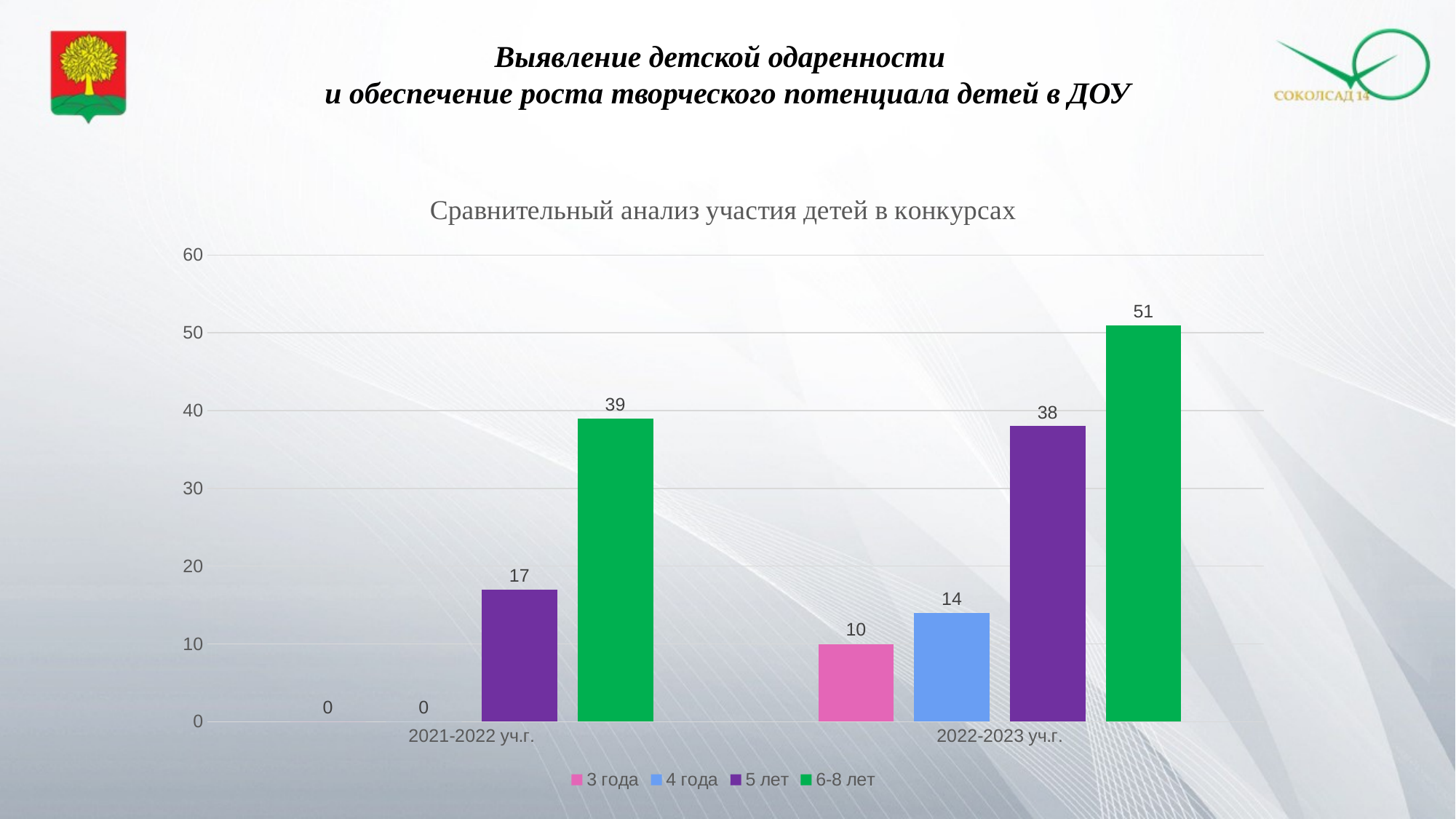
How many series does the legend list? 4 How many categories are shown on the x axis? 2 What kind of chart is shown on the slide? Bar chart Which is larger: the 5 лет value in 2022-2023 уч.г. or the 6-8 лет value in 2021-2022 уч.г.? 6-8 лет value in 2021-2022 уч.г. What is the difference between the 6-8 лет values for 2022-2023 уч.г. and 2021-2022 уч.г.? 12 What is the title of the chart? Сравнительный анализ участия детей в конкурсах What is the value for the 3 года series in 2021-2022 уч.г.? 0 What is the value for the 6-8 лет series in 2022-2023 уч.г.? 51 Which series has the highest value in 2022-2023 уч.г.? 6-8 лет What is the value for the 4 года series in 2022-2023 уч.г.? 14 What is the value for the 5 лет series in 2021-2022 уч.г.? 17 Which series has the lowest value in 2022-2023 уч.г.? 3 года